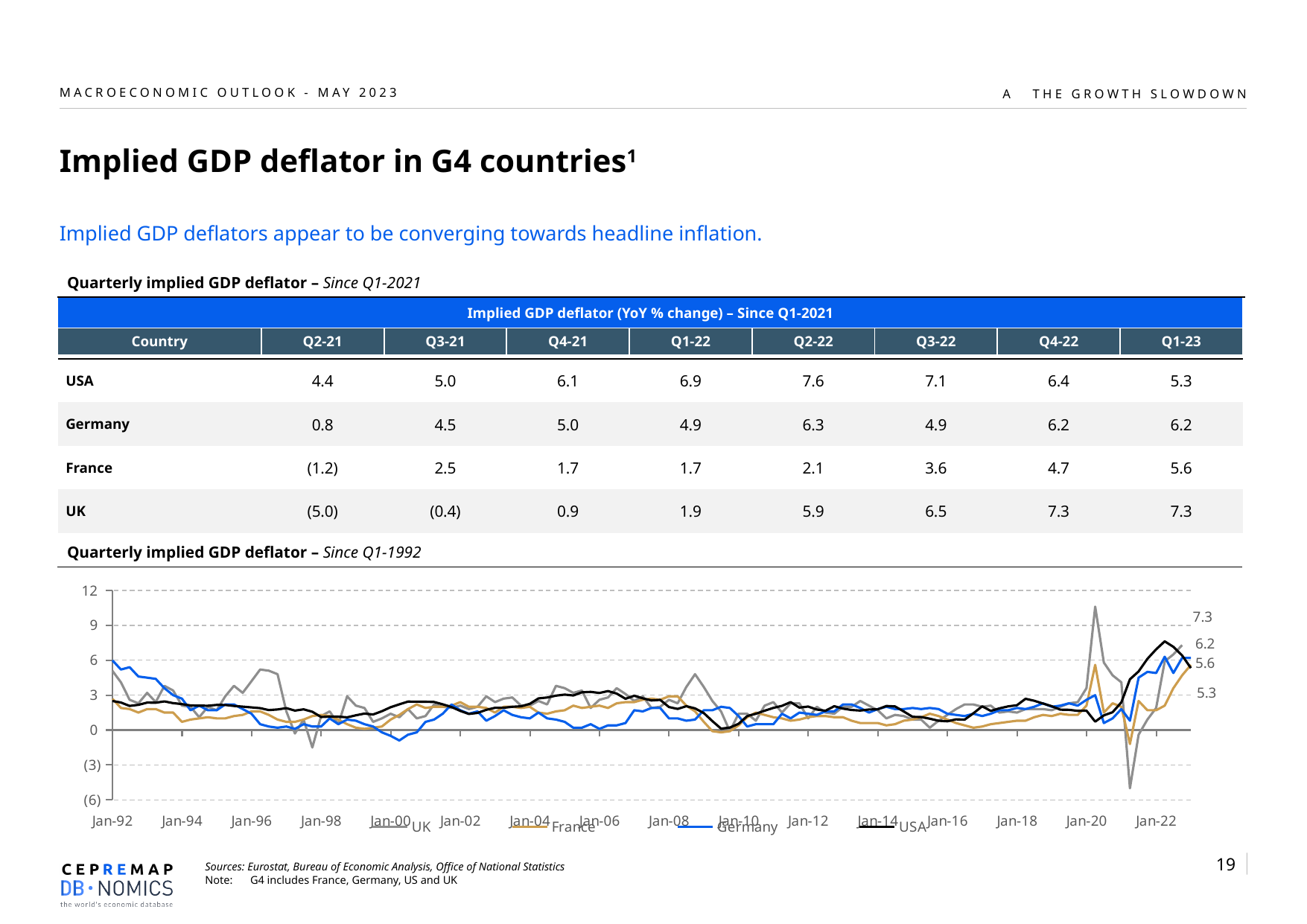
In the line chart, what is the latest labelled value for the USA series? 5.3 In the line chart, which country has the highest value at the end of the series (Q1-23)? UK In the line chart, what is the latest labelled value for the UK series? 7.3 In the line chart, what is the difference between the latest labelled values for the UK and the USA? 2.0 In the line chart, is the latest value for France larger or smaller than the latest value for Germany? smaller In the line chart, which colour is used for the Germany series? blue What kind of chart is the 'Quarterly implied GDP deflator – Since Q1-1992' chart? line chart How many series does the legend of the line chart list? 4 In the line chart, what is the latest labelled value for the Germany series? 6.2 In the line chart, does the USA series rise or fall between Jan-20 and Jan-22? rise In the line chart, which country has the lowest value at the end of the series (Q1-23)? USA In the line chart, is the UK series' peak around Jan-20 greater or less than 9? greater